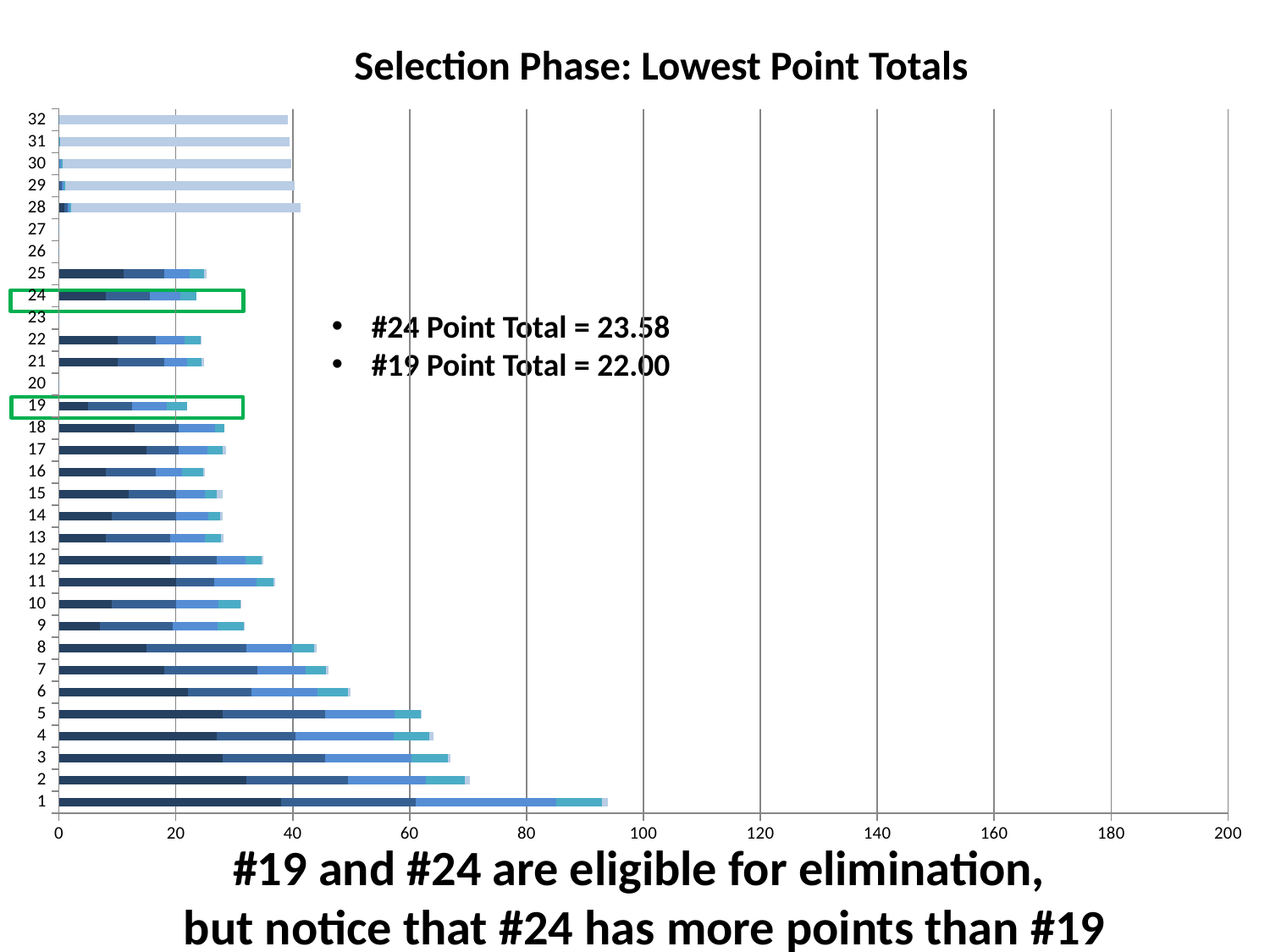
According to the slide, what is the point total for #19? 22.00 What is the difference between the point totals of #24 and #19? 1.58 Which two categories are highlighted with green boxes on the chart? 19 and 24 Is the total bar length for category 1 greater or less than 80? greater Is the total bar length for category 6 greater or less than 60? less What kind of chart is shown on the slide? bar chart Which has the higher point total, #24 or #19? #24 What is the title of the chart? Selection Phase: Lowest Point Totals How many categories are listed on the vertical axis of the chart? 32 Which category has the longest bar in the chart? 1 According to the slide, what is the point total for #24? 23.58 Which category has a longer bar, 5 or 6? 5